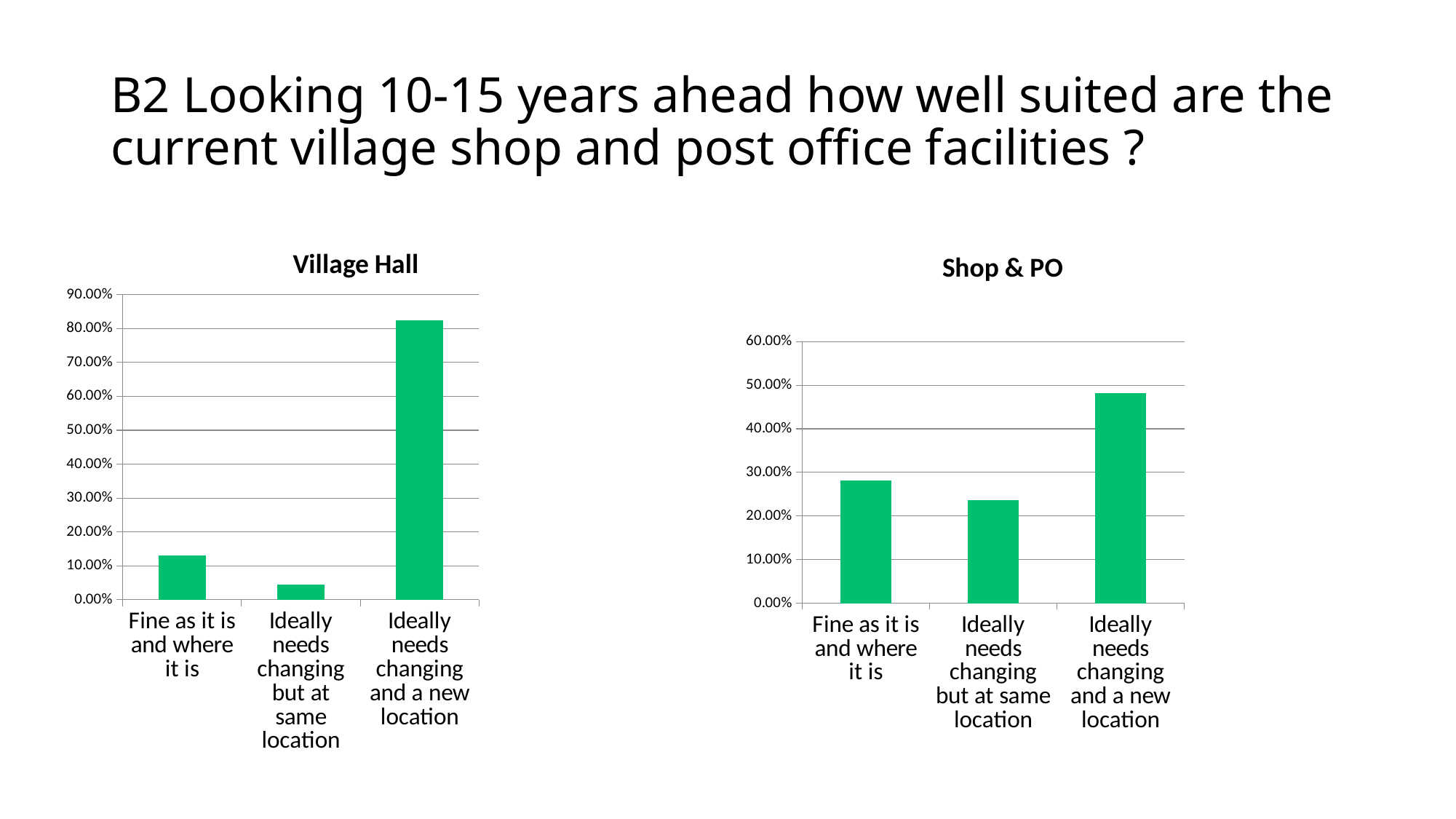
What type of chart is the Shop & PO chart? Bar chart In the Shop & PO chart, which category has the lowest value? Ideally needs changing but at same location In the Village Hall chart, is the value for 'Ideally needs changing and a new location' greater or less than 80.00%? greater In the Village Hall chart, is the value for 'Fine as it is and where it is' greater or less than 20.00%? less In the Shop & PO chart, is the value for 'Fine as it is and where it is' greater or less than 30.00%? less In the Village Hall chart, which category has the highest value? Ideally needs changing and a new location How many categories are shown in the Village Hall chart? 3 What is the title of the chart on the right side of the slide? Shop & PO In the Village Hall chart, which category has the lowest value? Ideally needs changing but at same location In the Shop & PO chart, which category has the highest value? Ideally needs changing and a new location In the Shop & PO chart, which is larger: 'Fine as it is and where it is' or 'Ideally needs changing but at same location'? Fine as it is and where it is